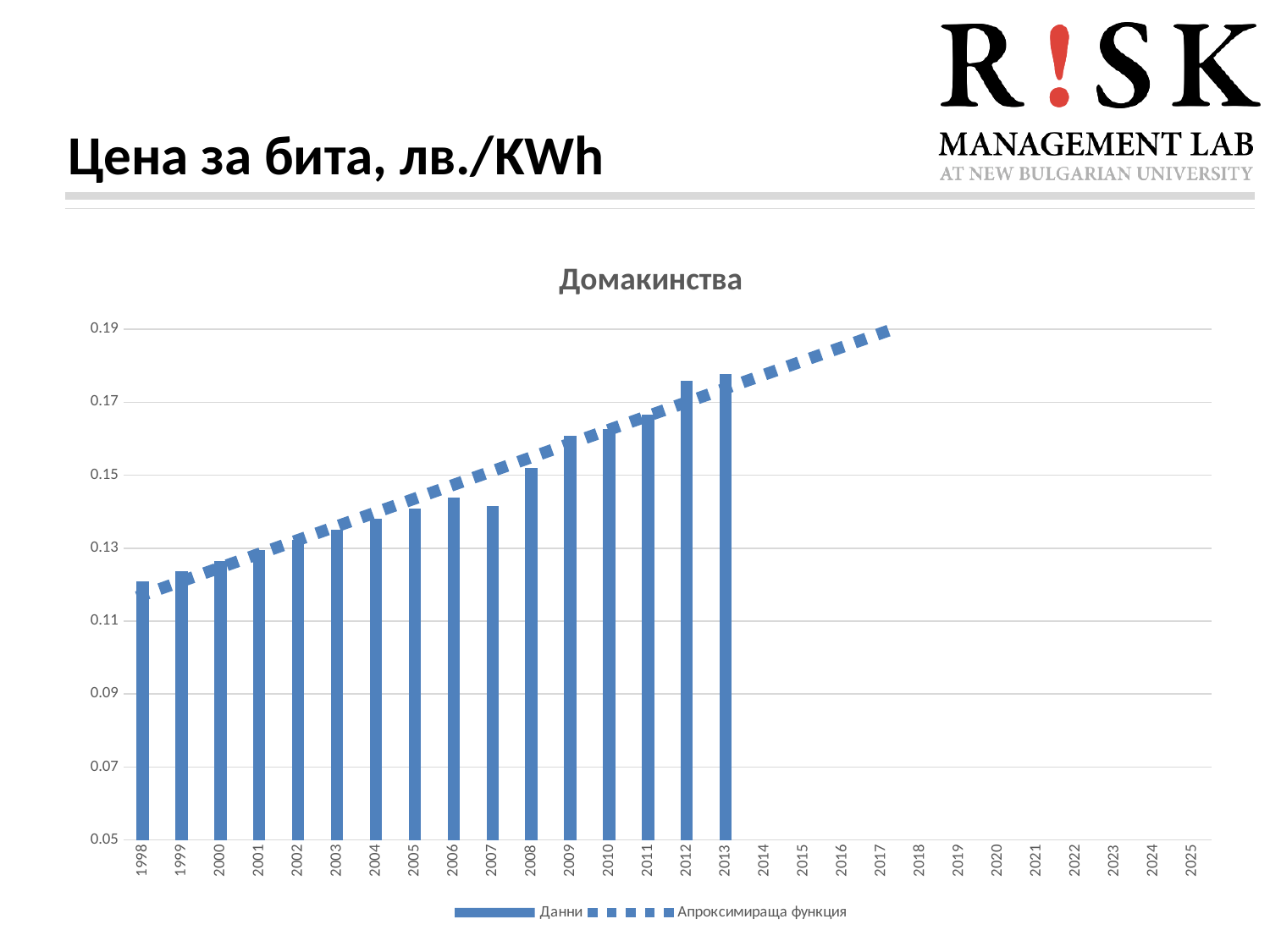
Which year has the highest bar? 2013 How many series does the legend list? 2 Is the value for 2010 greater or less than 0.15? greater Which year has the larger bar, 2005 or 2009? 2009 Which year has the lowest bar? 1998 What kind of chart is shown on the slide? bar chart What is the title of the chart? Домакинства Is the value for 2007 greater or less than 0.15? less How many years have a bar plotted in the chart? 16 What are the two entries in the chart legend? Данни and Апроксимираща функция Is the value for 2012 greater or less than 0.17? greater Do the bar values generally rise or fall from 1998 to 2013? rise